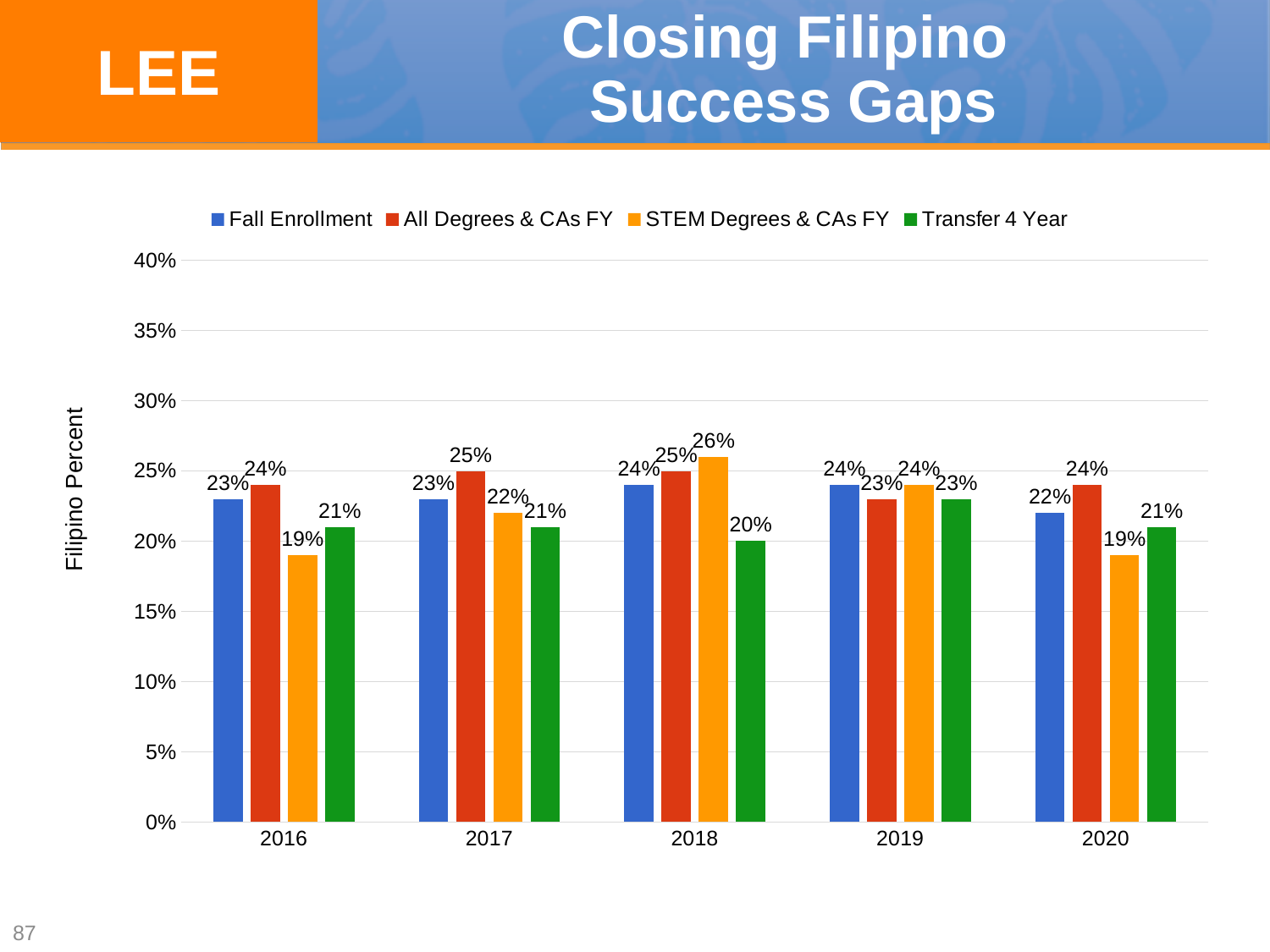
What kind of chart is shown on the slide? Bar chart What is the difference between the STEM Degrees & CAs FY value and the Transfer 4 Year value in 2018? 6% What is the label on the vertical axis? Filipino Percent In which year is the STEM Degrees & CAs FY value highest? 2018 What is the All Degrees & CAs FY value for 2020? 24% How many years are shown on the x axis? 5 How many series does the legend list? 4 In which year is the Transfer 4 Year value lowest? 2018 What is the Fall Enrollment value for 2016? 23% Which is larger in 2017: the All Degrees & CAs FY value or the STEM Degrees & CAs FY value? All Degrees & CAs FY What is the STEM Degrees & CAs FY value for 2018? 26% What is the Transfer 4 Year value for 2019? 23%